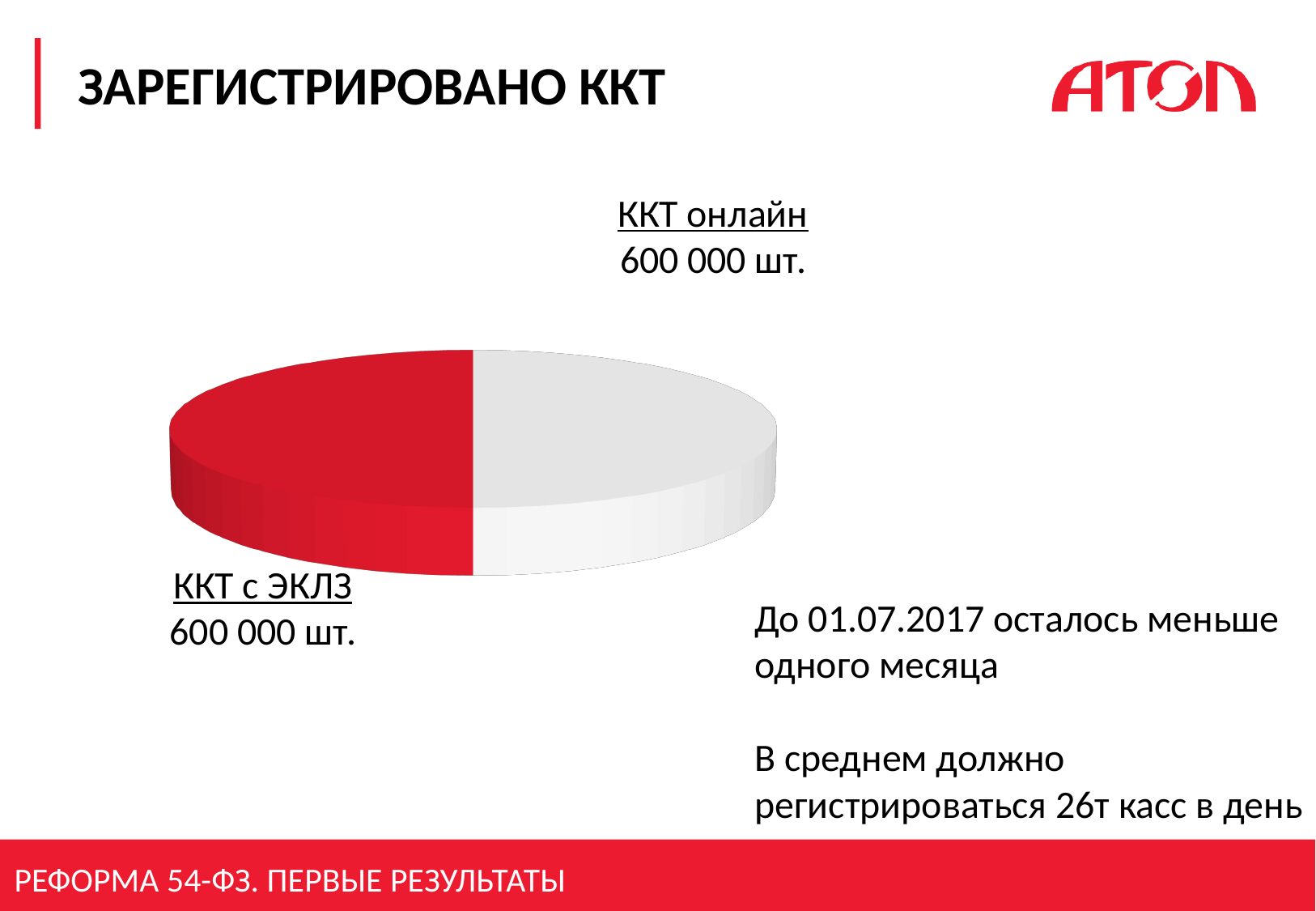
How many slices does the pie chart have? 2 What colour is the ККТ с ЭКЛЗ slice in the pie chart? Red What is the total of the two slices in the pie chart? 1 200 000 шт. What share of the pie does the ККТ онлайн slice represent? 50% Which is larger, the value for ККТ онлайн or the value for ККТ с ЭКЛЗ? They are equal What is the value shown for ККТ онлайн in the pie chart? 600 000 шт. What share of the pie does the ККТ с ЭКЛЗ slice represent? 50% What is the value shown for ККТ с ЭКЛЗ in the pie chart? 600 000 шт. What kind of chart is shown on the slide? Pie chart What is the title of the slide containing the pie chart? ЗАРЕГИСТРИРОВАНО ККТ What is the difference between the values for ККТ онлайн and ККТ с ЭКЛЗ? 0